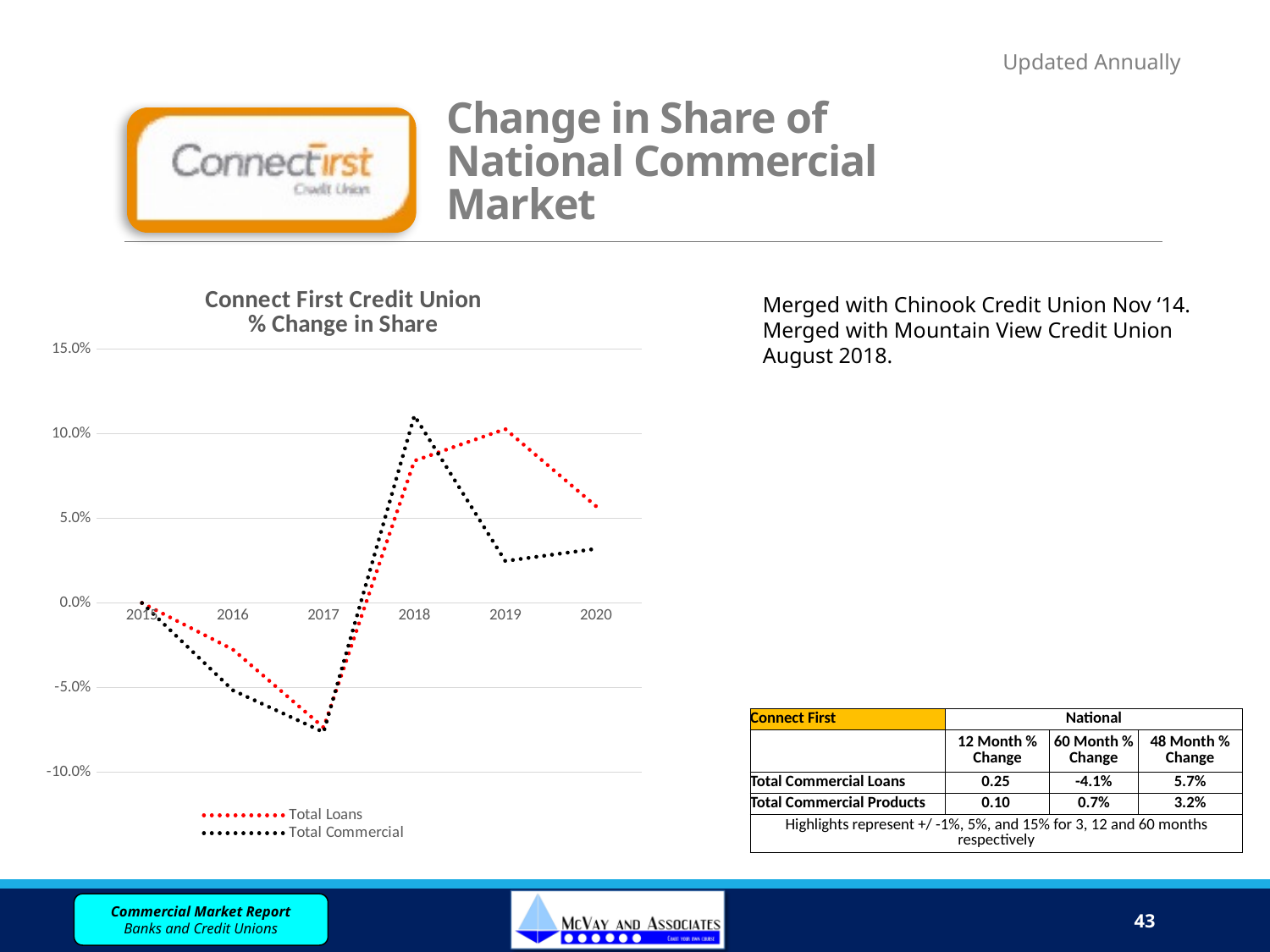
In which year does the Total Commercial series reach its highest value? 2018 Is the Total Loans value for 2017 greater or less than -5.0%? less Does the Total Loans series rise or fall from 2015 to 2017? fall Is the Total Commercial value for 2018 greater or less than 10.0%? greater Is the Total Commercial value for 2019 greater or less than 5.0%? less In which year does the Total Loans series reach its highest value? 2019 In 2018, which series has the higher value, Total Loans or Total Commercial? Total Commercial How many series does the legend of the "Connect First Credit Union % Change in Share" chart list? 2 In 2019, which series has the higher value, Total Loans or Total Commercial? Total Loans How many years are plotted along the x axis of the "Connect First Credit Union % Change in Share" chart? 6 In which year does the Total Loans series reach its lowest value? 2017 What kind of chart is the "Connect First Credit Union % Change in Share" chart? line chart